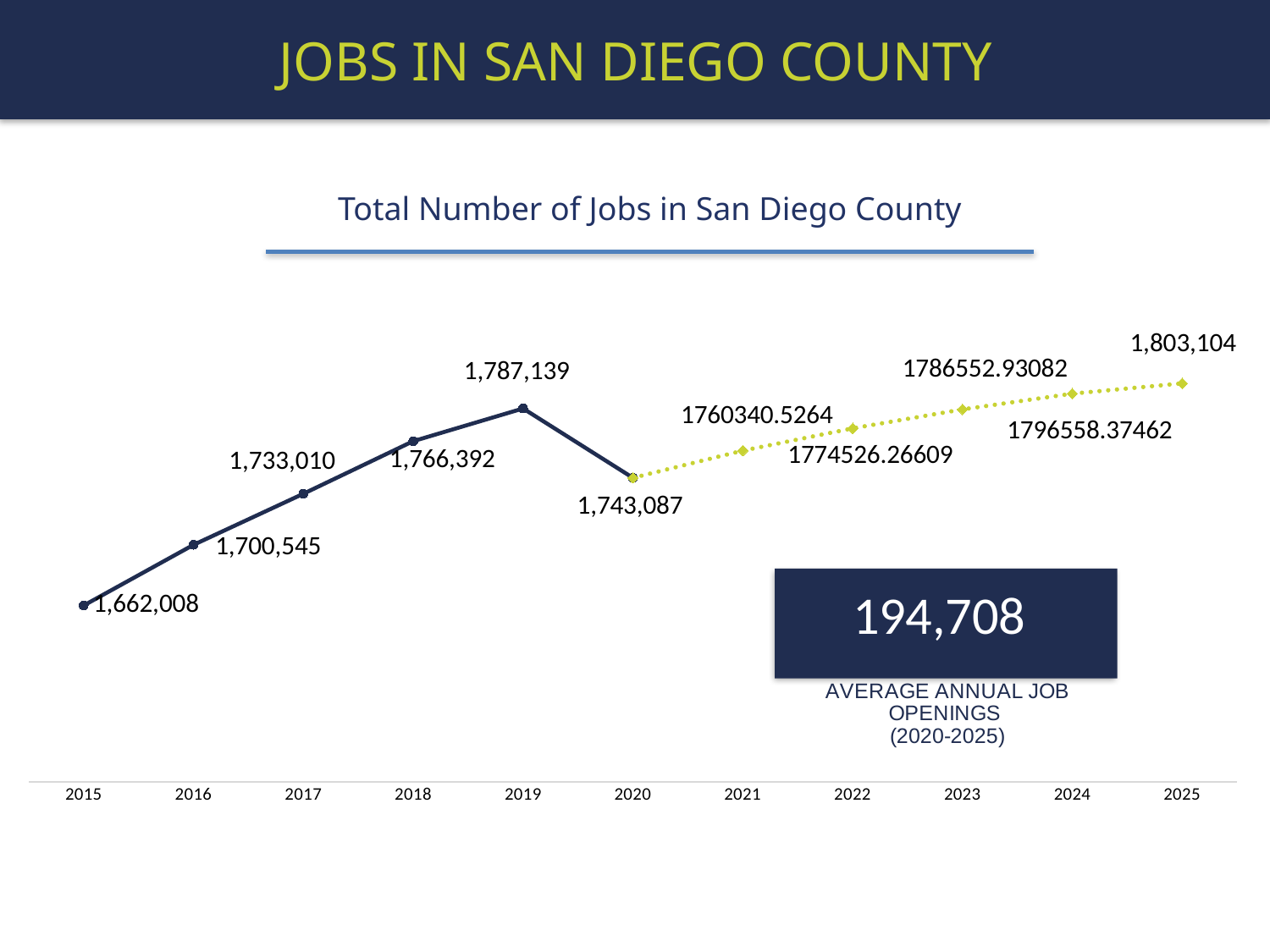
What is the number of jobs shown for 2020? 1,743,087 Do the values rise or fall from 2015 to 2019? Rise What value is labelled for 2019 on the chart? 1,787,139 Which year has the lowest number of jobs on the chart? 2015 What is the total number of jobs in San Diego County shown for 2015? 1,662,008 By how much did the number of jobs fall from 2019 to 2020? 44,052 Which year has more jobs, 2018 or 2020? 2018 How many years are plotted on the x axis of the chart? 11 What value is labelled for 2025 on the chart? 1,803,104 What kind of chart is used to show the total number of jobs? Line chart Which year has the highest number of jobs on the chart? 2025 What value is labelled for 2022 on the chart? 1774526.26609